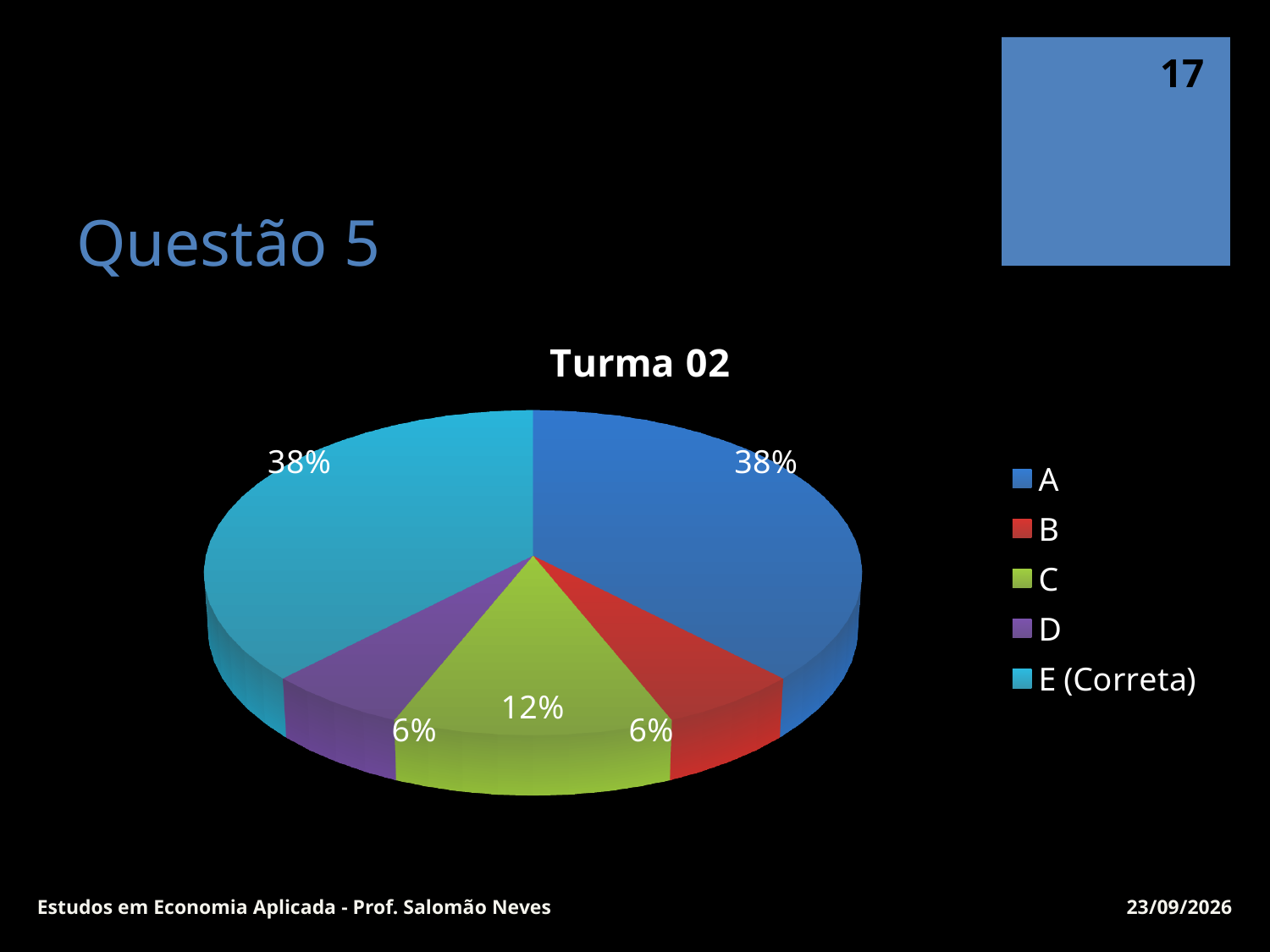
What is the value shown for slice D? 6% How many slices does the pie chart have? 5 What is the value shown for slice C? 12% What share of the pie does slice A represent? 38% Which is larger, the share for C or the share for B? C What is the difference between the share for A and the share for C? 26% What is the value shown for slice B? 6% What type of chart is shown on the slide? pie chart Which legend entry is marked as the correct answer? E (Correta) How many entries does the legend list? 5 What is the title of the chart? Turma 02 What share of the pie does slice E (Correta) represent? 38%